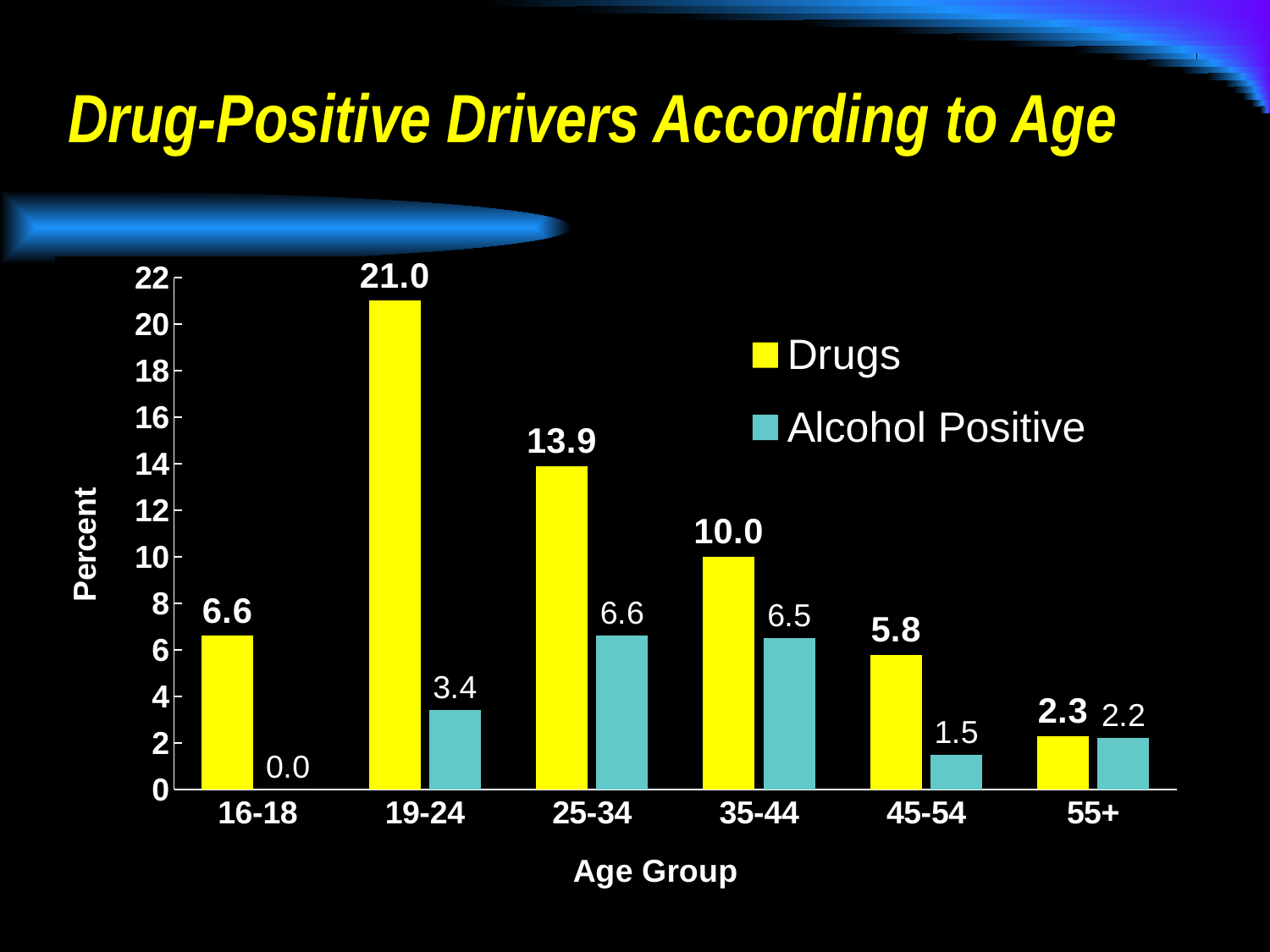
What is the difference between the Drugs and Alcohol Positive values for the 25-34 age group? 7.3 How many series does the legend list? 2 Is the Drugs value for the 35-44 age group greater or less than 8? greater Which age group has the lowest Alcohol Positive value? 16-18 Which is larger for the 45-54 age group, the Drugs value or the Alcohol Positive value? Drugs What kind of chart is shown on the slide? Bar chart What is the title of the chart? Drug-Positive Drivers According to Age What is the Alcohol Positive value for the 16-18 age group? 0.0 What is the Drugs value for the 19-24 age group? 21.0 Which age group has the highest Drugs value? 19-24 How many age groups are shown on the x axis? 6 What is the Alcohol Positive value for the 35-44 age group? 6.5